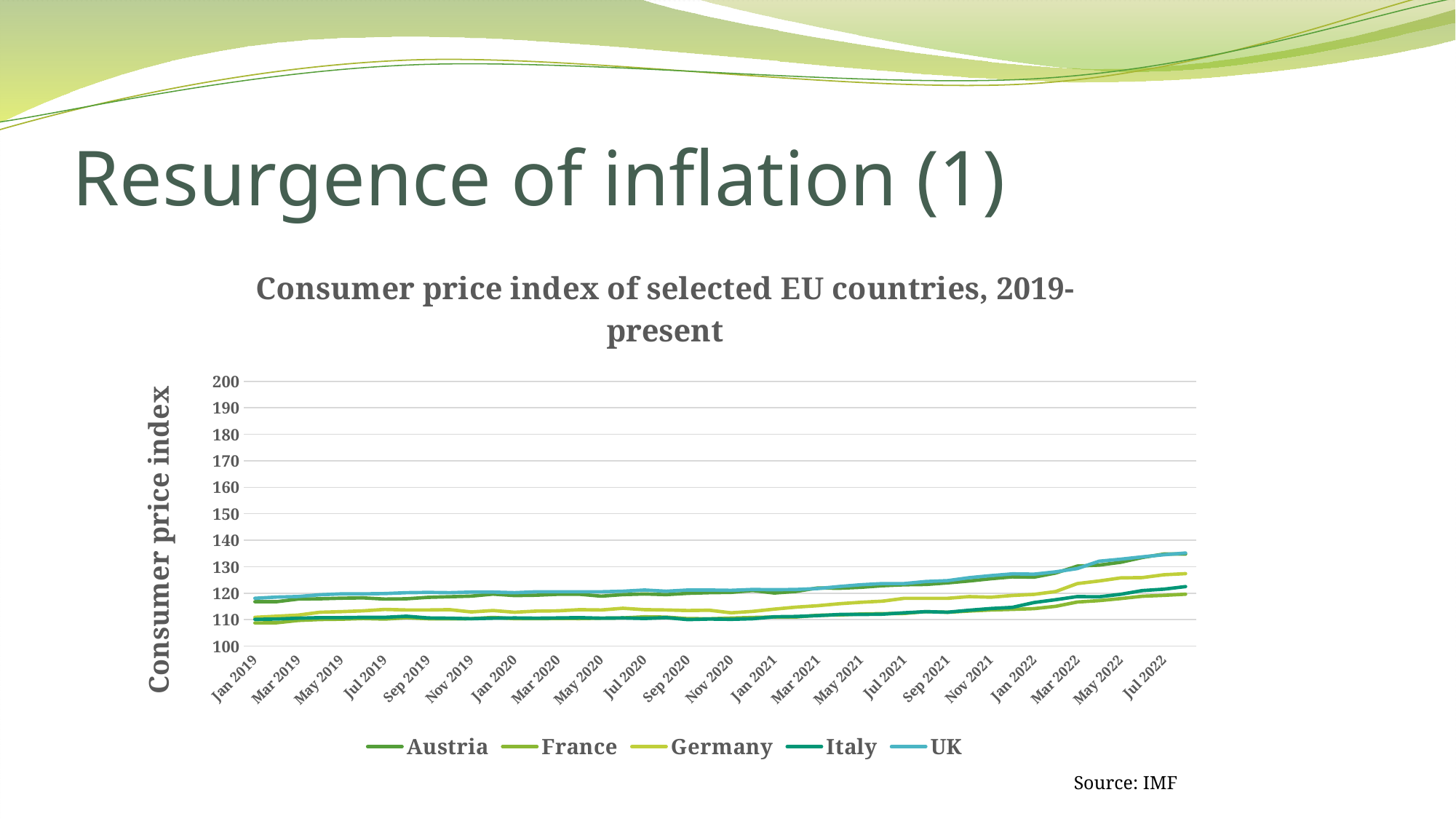
Is the value for the UK in Jan 2019 greater or less than 110? greater How many series does the legend list? 5 Is the value for France in Jan 2019 greater or less than 120? less Is the value for Austria in Jul 2022 greater or less than 130? greater What is the label on the vertical axis? Consumer price index What kind of chart is shown on the slide? Line chart In Jan 2019, which is higher: the UK or France? UK Do the values for the UK rise or fall from Jan 2019 to Jul 2022? Rise In Jul 2022, which is higher: Germany or France? Germany Do the values for Germany rise or fall overall across the period shown? Rise What is the title of the chart? Consumer price index of selected EU countries, 2019-present